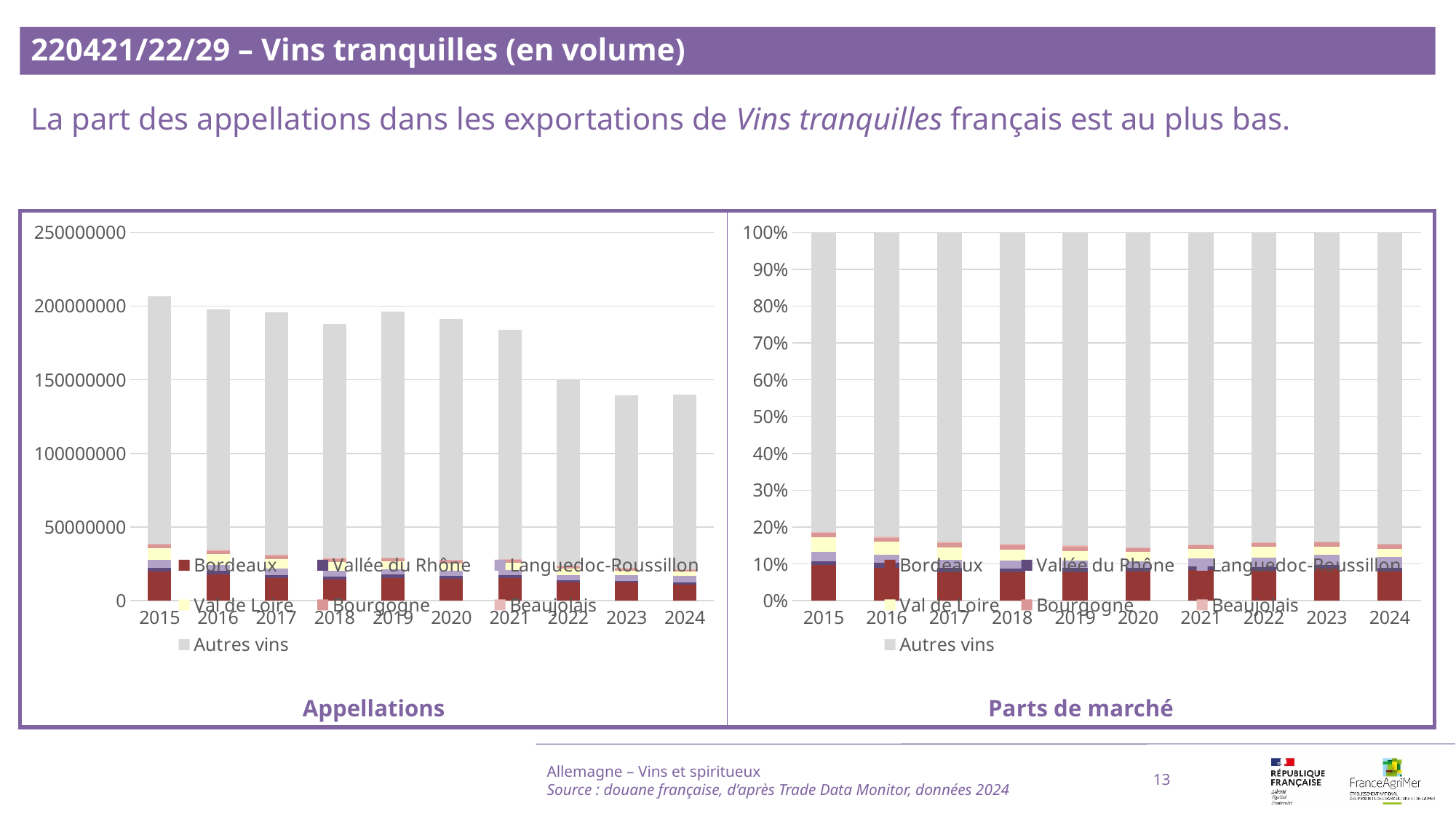
How many series does the legend of the 'Appellations' chart list? 7 How many years are shown on the x axis of the 'Parts de marché' chart? 10 In the 'Parts de marché' chart, what is the total height of each stacked bar? 100% In the 'Appellations' chart, is the total bar for 2015 larger or smaller than the total bar for 2024? larger In the 'Appellations' chart, do the total bars generally rise or fall from 2015 to 2024? fall In the 'Appellations' chart, is the total bar for 2018 greater or less than 200000000? less Which legend entry is shown in grey in both charts? Autres vins What kind of chart is the 'Appellations' chart on the left? stacked bar chart In the 'Appellations' chart, is the total bar for 2023 greater or less than 150000000? less In the 'Appellations' chart, is the total bar for 2015 greater or less than 200000000? greater In the 'Appellations' chart, which year has the highest total bar? 2015